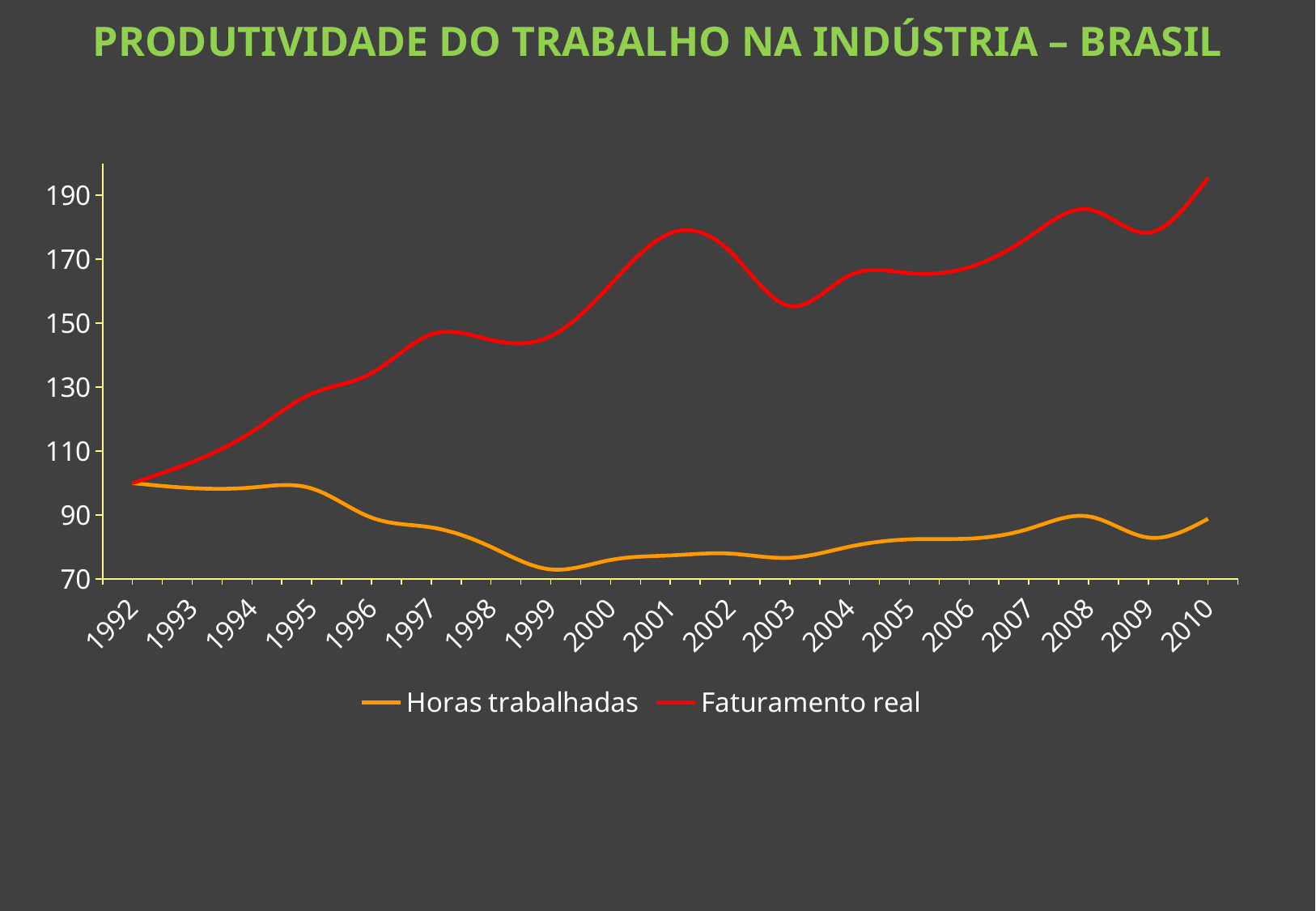
What colour is the line for Horas trabalhadas? Orange Is the value of Horas trabalhadas in 1999 greater or less than 90? less Is the value of Faturamento real in 2010 greater or less than 190? greater In which year does the Faturamento real series reach its highest value? 2010 Which series has the higher value in 2010, Horas trabalhadas or Faturamento real? Faturamento real In which year does the Horas trabalhadas series reach its lowest value? 1999 How many series does the legend list? 2 What kind of chart is shown on the slide? Line chart Is the value of Faturamento real in 2001 greater or less than 170? greater Does the Faturamento real series rise or fall overall from 1992 to 2010? Rise How many years are shown along the x axis? 19 In which year does the Faturamento real series have its lowest value? 1992